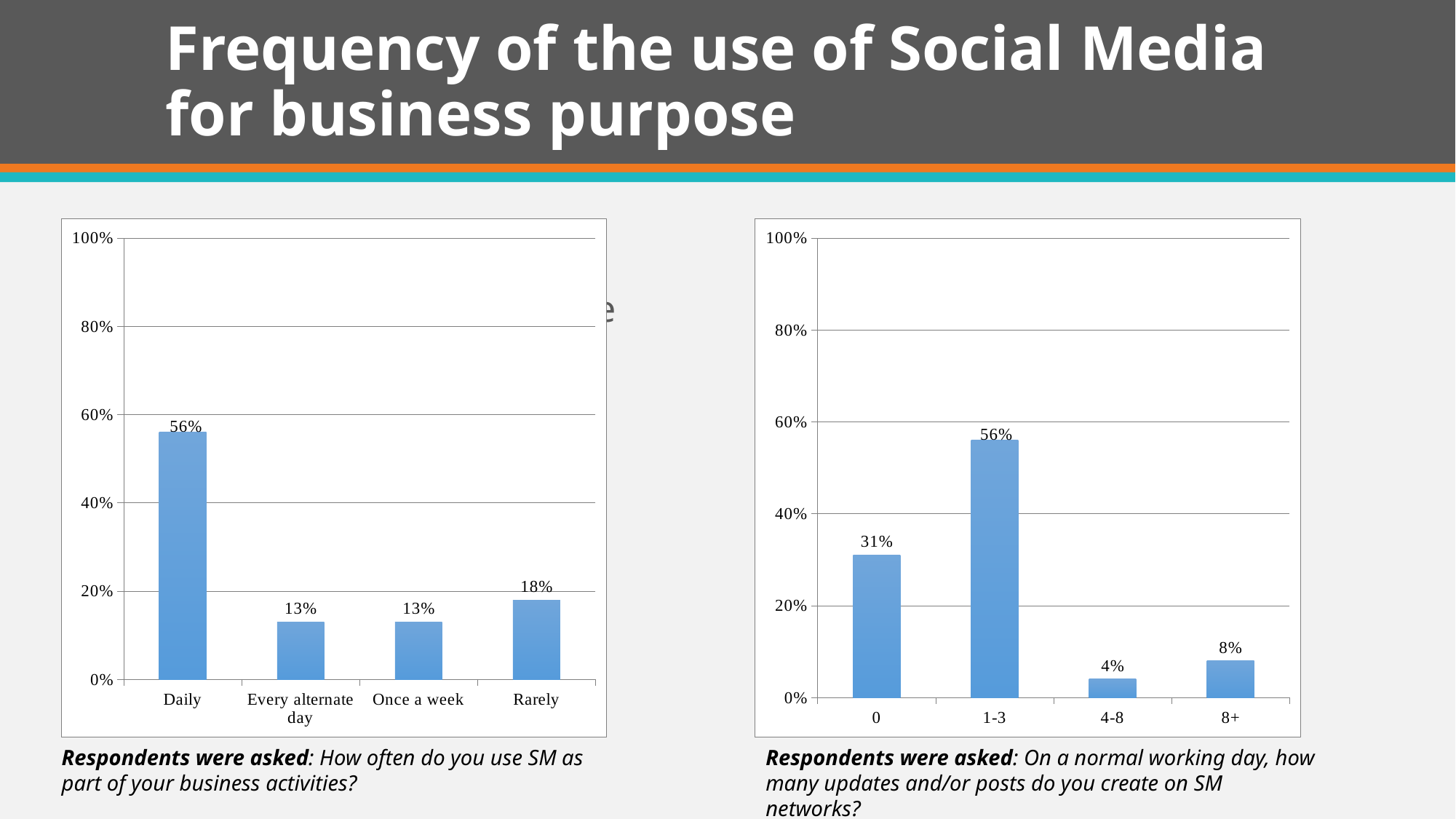
In the right chart, which category has the lowest value? 4-8 In the right chart, which is larger, the value for 0 or the value for 8+? 0 In the left chart, what is the value for Daily? 56% In the right chart, what is the difference between the values for 1-3 and 0? 25% In the right chart, what is the value for 1-3? 56% In the right chart, what is the value for 4-8? 4% What type of chart is the right chart? Bar chart In the left chart, how many categories are shown on the x axis? 4 In the left chart, what is the difference between the values for Daily and Rarely? 38% In the left chart, which category has the highest value? Daily In the left chart, what is the value for Rarely? 18% In the left chart, is the value for Daily greater or less than 40%? greater